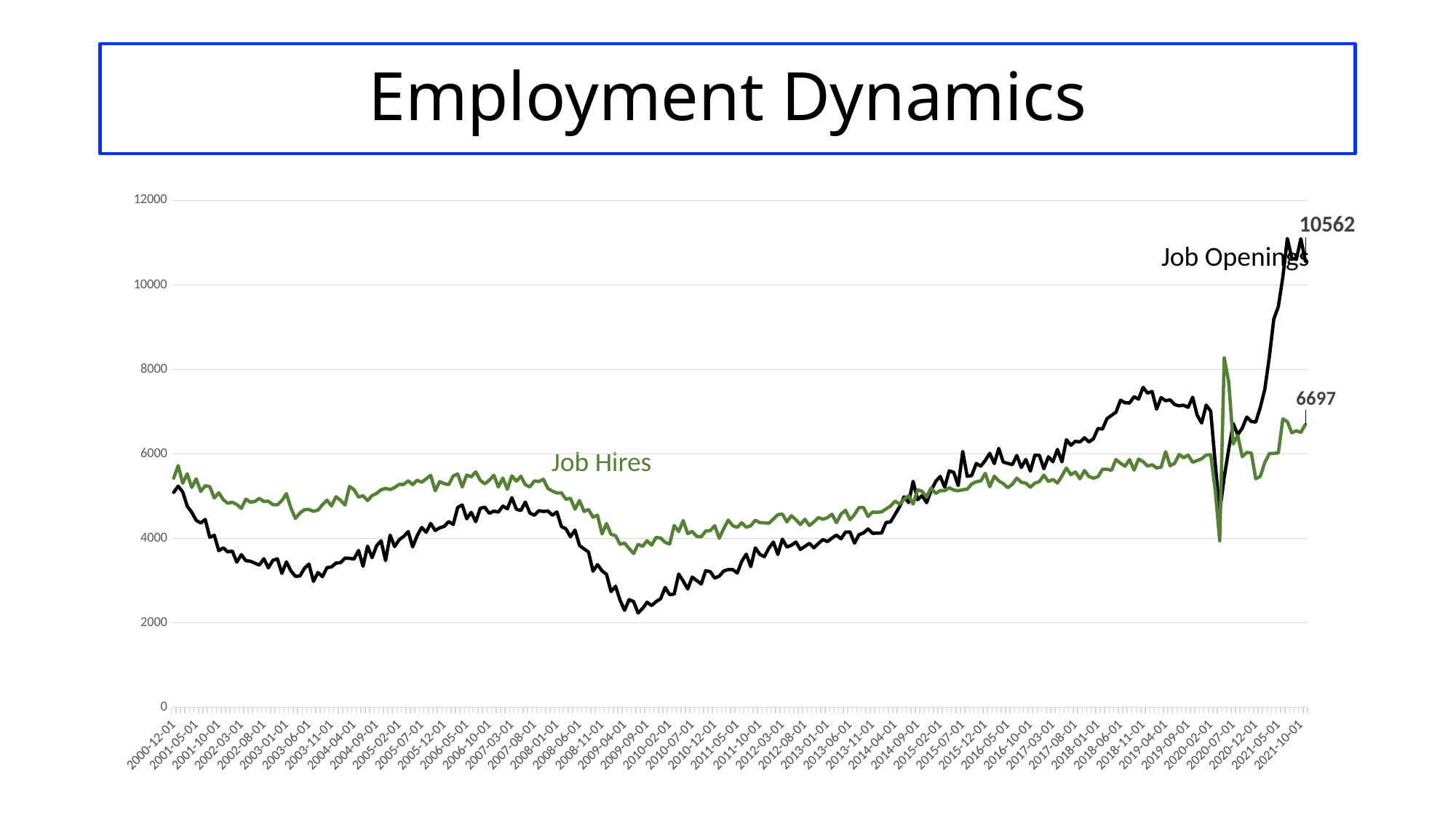
What is the final labelled value of the Job Hires series? 6697 What is the difference between the final labelled values of Job Openings and Job Hires? 3865 What colour is the Job Hires line? green Which series reaches the highest value anywhere on the chart? Job Openings At the end of the chart, which series has the larger value, Job Openings or Job Hires? Job Openings Is the value for Job Hires at 2000-12-01 greater or less than 4000? greater Does the Job Openings series generally rise or fall between 2009-09-01 and 2018-11-01? rise What is the final labelled value of the Job Openings series? 10562 What kind of chart is shown on the slide? line chart Is the value for Job Openings at 2018-11-01 greater or less than 6000? greater How many data series are plotted on the chart? 2 Is the value for Job Openings at 2009-09-01 greater or less than 4000? less